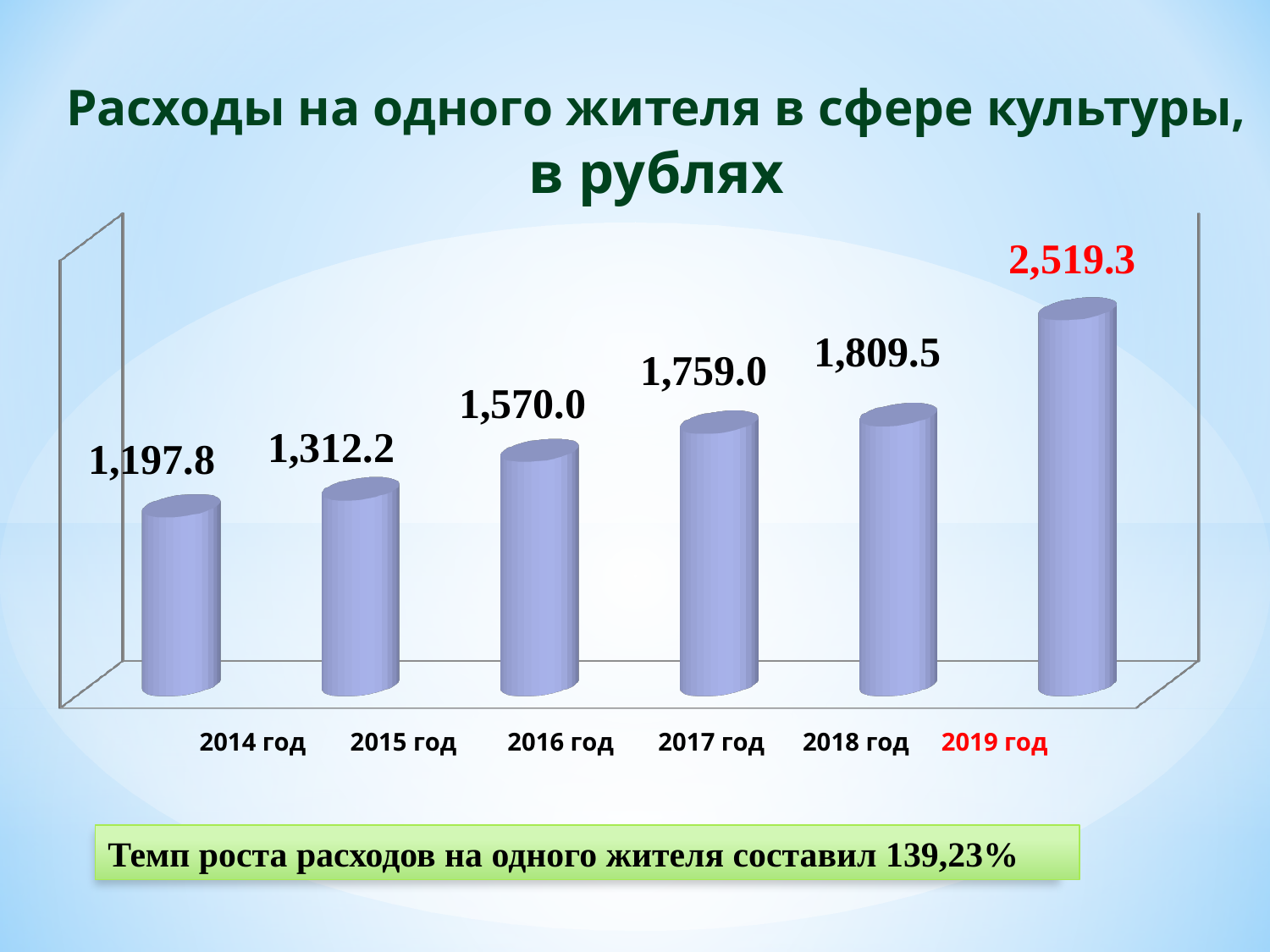
What is the value for 2019 год? 2,519.3 What is the difference between the values for 2015 год and 2014 год? 114.4 Do the values rise or fall from 2014 год to 2019 год? rise What kind of chart is shown on the slide? bar chart What is the difference between the values for 2019 год and 2018 год? 709.8 Which is larger, the value for 2017 год or the value for 2016 год? 2017 год Which year has the highest value? 2019 год How many years are shown on the chart? 6 What is the value for 2014 год? 1,197.8 What is the title of the chart? Расходы на одного жителя в сфере культуры, в рублях Which year has the lowest value? 2014 год What is the value for 2016 год? 1,570.0